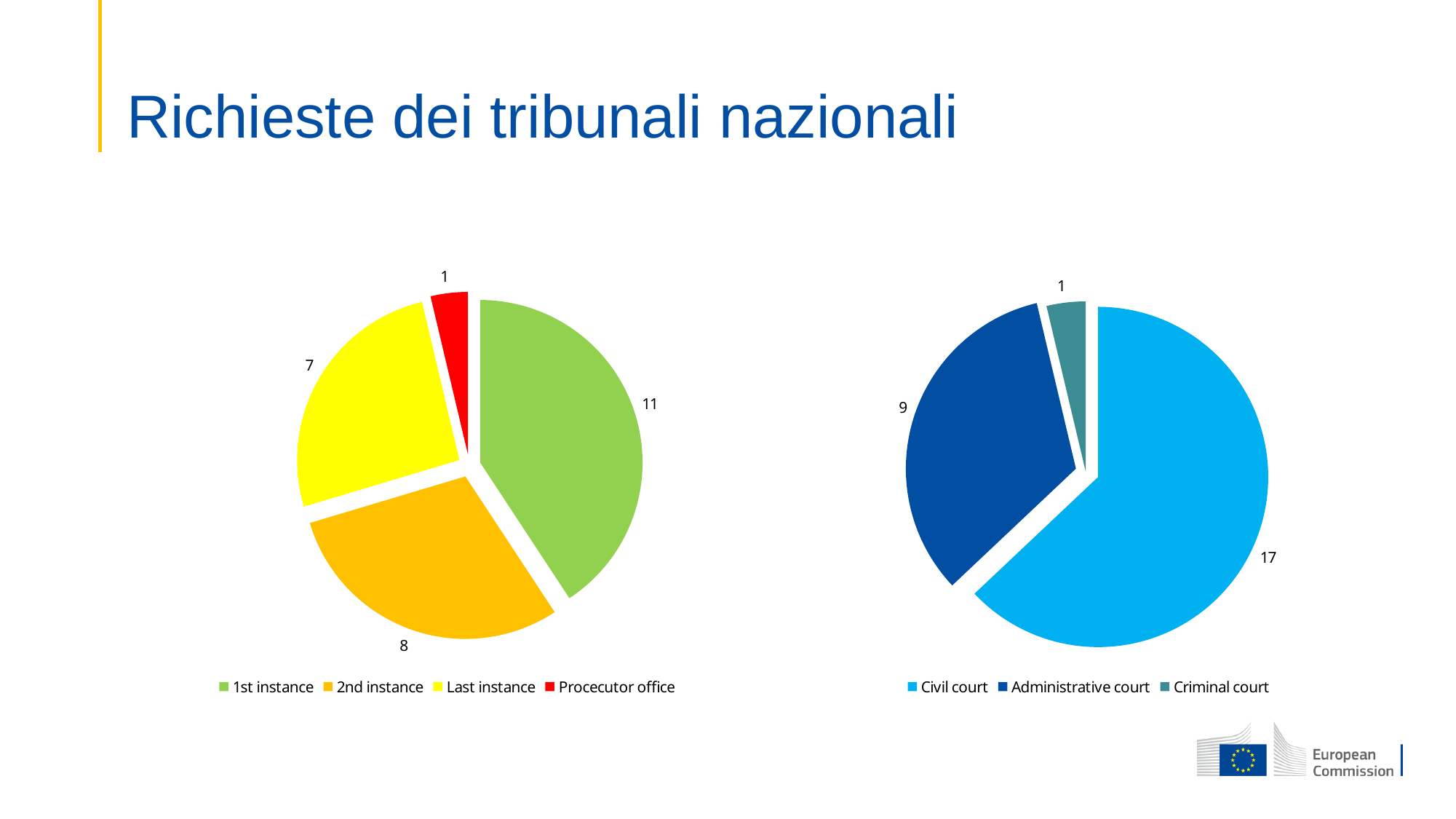
In the right pie chart, what is the difference between the values for Civil court and Administrative court? 8 In the left pie chart, which category has the smallest slice? Procecutor office In the left pie chart, what is the difference between the values for 1st instance and 2nd instance? 3 What is the total of all slices in the right pie chart? 27 How many categories does the left pie chart show? 4 In the right pie chart, what is the value for Administrative court? 9 In the right pie chart, which category has the largest slice? Civil court What type of chart is the right chart on the slide? Pie chart In the left pie chart, what is the value for 1st instance? 11 In the left pie chart, which is larger: 2nd instance or Last instance? 2nd instance In the left pie chart, what is the value for Last instance? 7 How many categories does the right pie chart show? 3